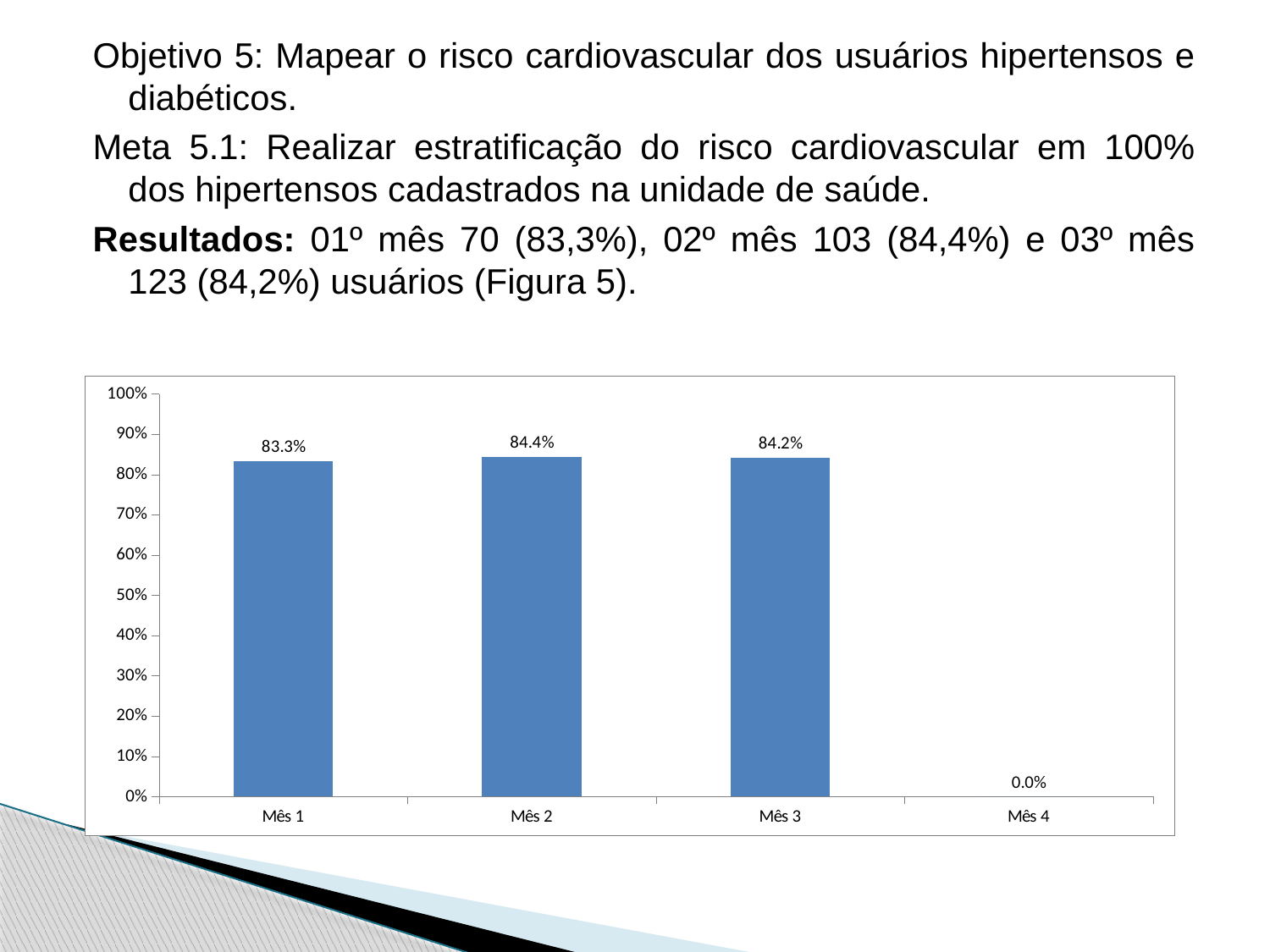
How many categories are shown on the x axis? 4 What kind of chart is shown on the slide? bar chart Which category has the lowest value? Mês 4 What is the value for Mês 1? 83.3% What is the value for Mês 3? 84.2% What is the value for Mês 4? 0.0% Is the value for Mês 3 greater or less than 80%? greater What is the highest value shown on the y axis? 100% What is the difference between the values for Mês 2 and Mês 1? 1.1% Which is larger, the value for Mês 1 or the value for Mês 3? Mês 3 Which category has the highest value? Mês 2 What is the value for Mês 2? 84.4%